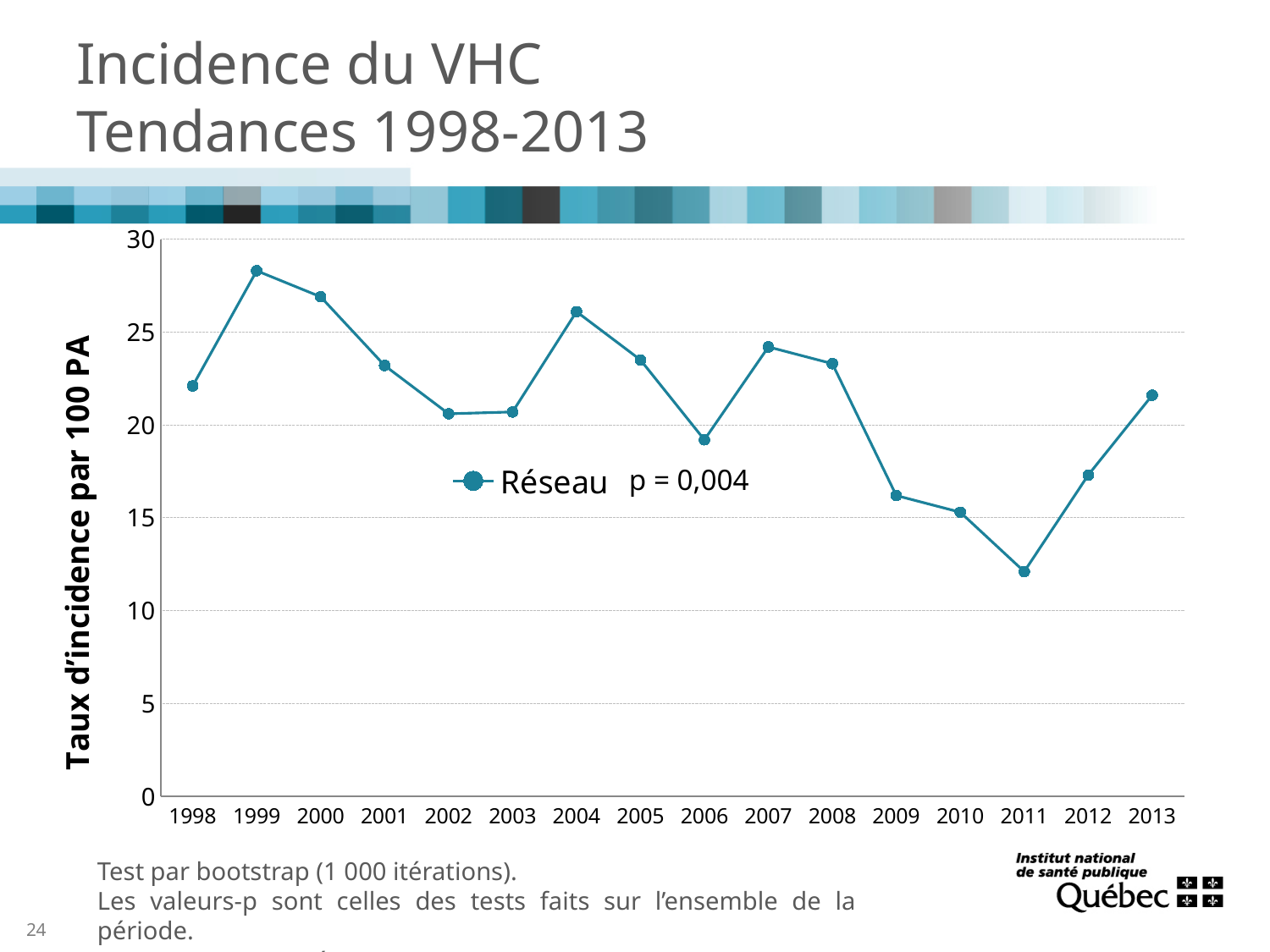
Which year has the highest incidence rate? 1999 Is the value for 2013 greater or less than 20? greater Is the value for 2006 greater or less than 20? less Is the value for 2011 greater or less than 15? less What kind of chart is shown on the slide? line chart How many years are plotted along the x axis? 16 Which year has the lowest incidence rate? 2011 How many series does the legend list? 1 Does the incidence rate generally rise or fall from 1998 to 2011? fall Which year has a higher incidence rate, 2004 or 2006? 2004 What is the p-value shown next to the legend? p = 0,004